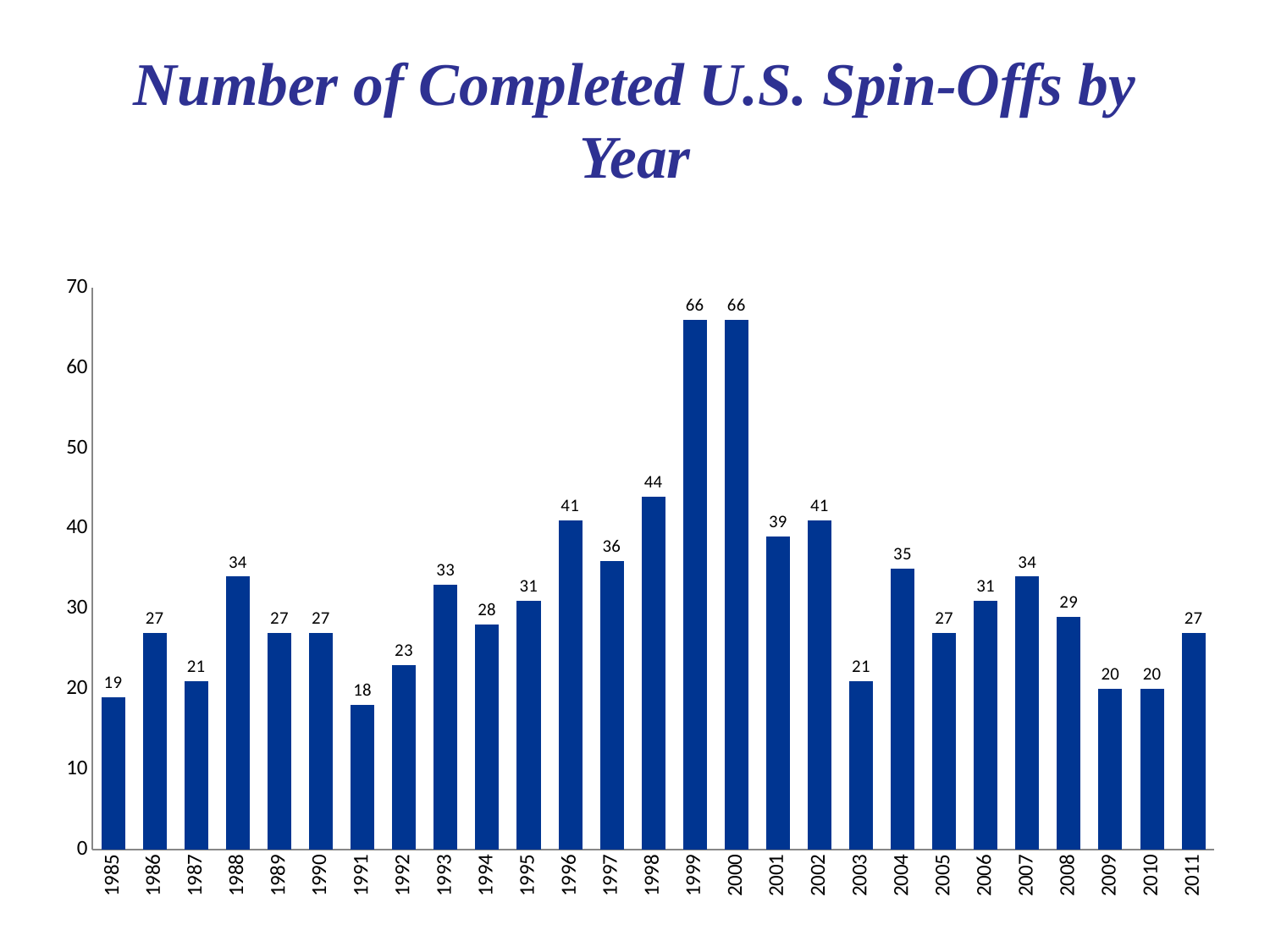
What is the difference between the values for 2000 and 2001? 27 Which year has the lowest number of completed spin-offs? 1991 What is the value shown for 1991? 18 What type of chart is shown on the slide? bar chart What is the title of the chart? Number of Completed U.S. Spin-Offs by Year Is the value for 2002 greater or less than 40? greater What is the highest value shown on the chart? 66 Which year has a larger value, 1996 or 1997? 1996 How many completed U.S. spin-offs were there in 1998? 44 What is the value shown for 2004? 35 How many years are shown on the x axis? 27